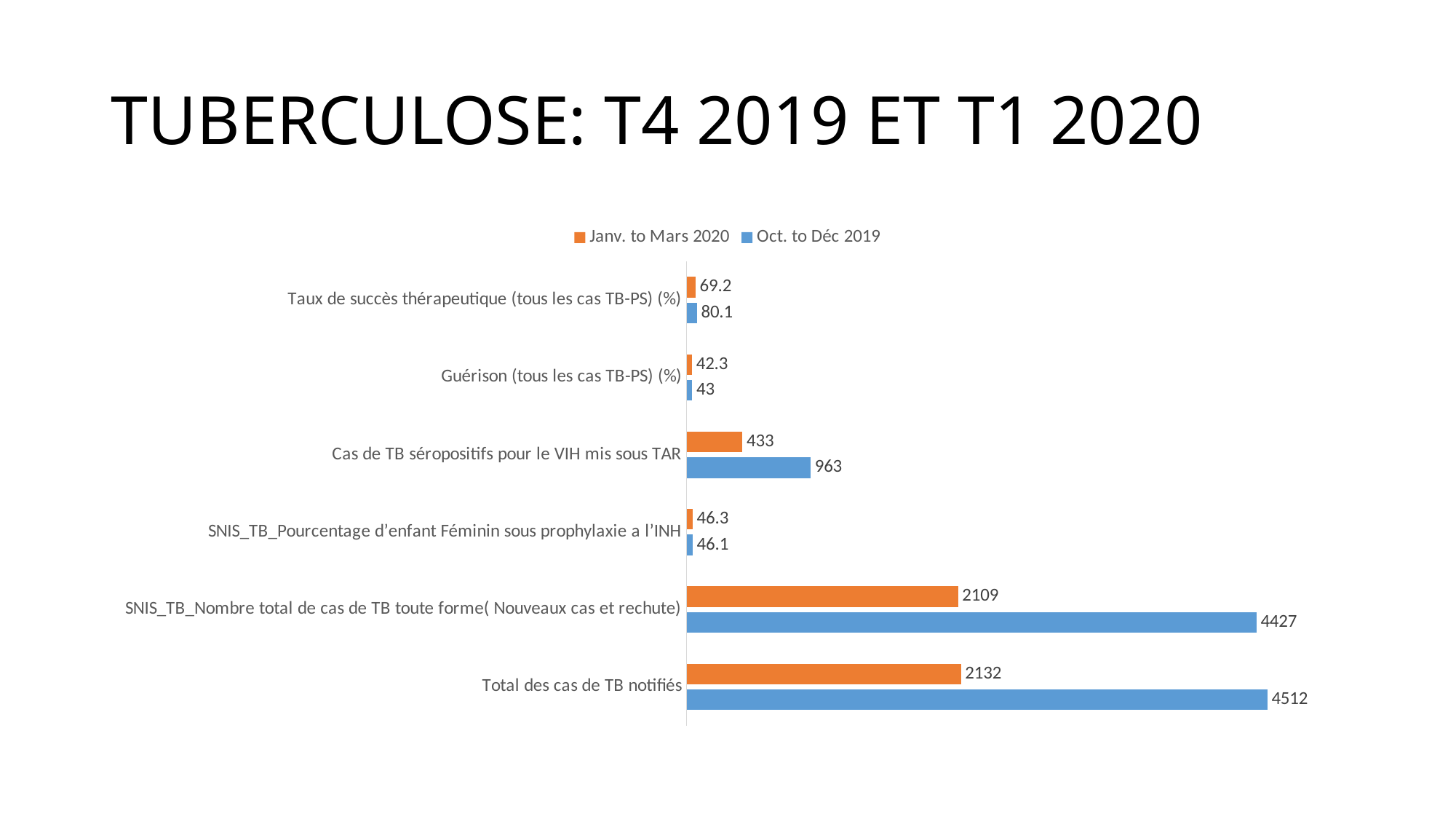
How many categories are shown on the chart? 6 What is the value for "Guérison (tous les cas TB-PS) (%)" in the Janv. to Mars 2020 series? 42.3 What is the difference between the Oct. to Déc 2019 and Janv. to Mars 2020 values for "Cas de TB séropositifs pour le VIH mis sous TAR"? 530 What is the value for "Taux de succès thérapeutique (tous les cas TB-PS) (%)" in the Oct. to Déc 2019 series? 80.1 Which category has the lowest value in the Janv. to Mars 2020 series? Guérison (tous les cas TB-PS) (%) What is the difference between the Oct. to Déc 2019 and Janv. to Mars 2020 values for "SNIS_TB_Nombre total de cas de TB toute forme( Nouveaux cas et rechute)"? 2318 What is the value for "Cas de TB séropositifs pour le VIH mis sous TAR" in the Janv. to Mars 2020 series? 433 What is the value for "Total des cas de TB notifiés" in the Oct. to Déc 2019 series? 4512 What kind of chart is shown on the slide? Bar chart For "Taux de succès thérapeutique (tous les cas TB-PS) (%)", which series has the larger value, Janv. to Mars 2020 or Oct. to Déc 2019? Oct. to Déc 2019 How many series does the legend list? 2 Which category has the highest value in the Oct. to Déc 2019 series? Total des cas de TB notifiés